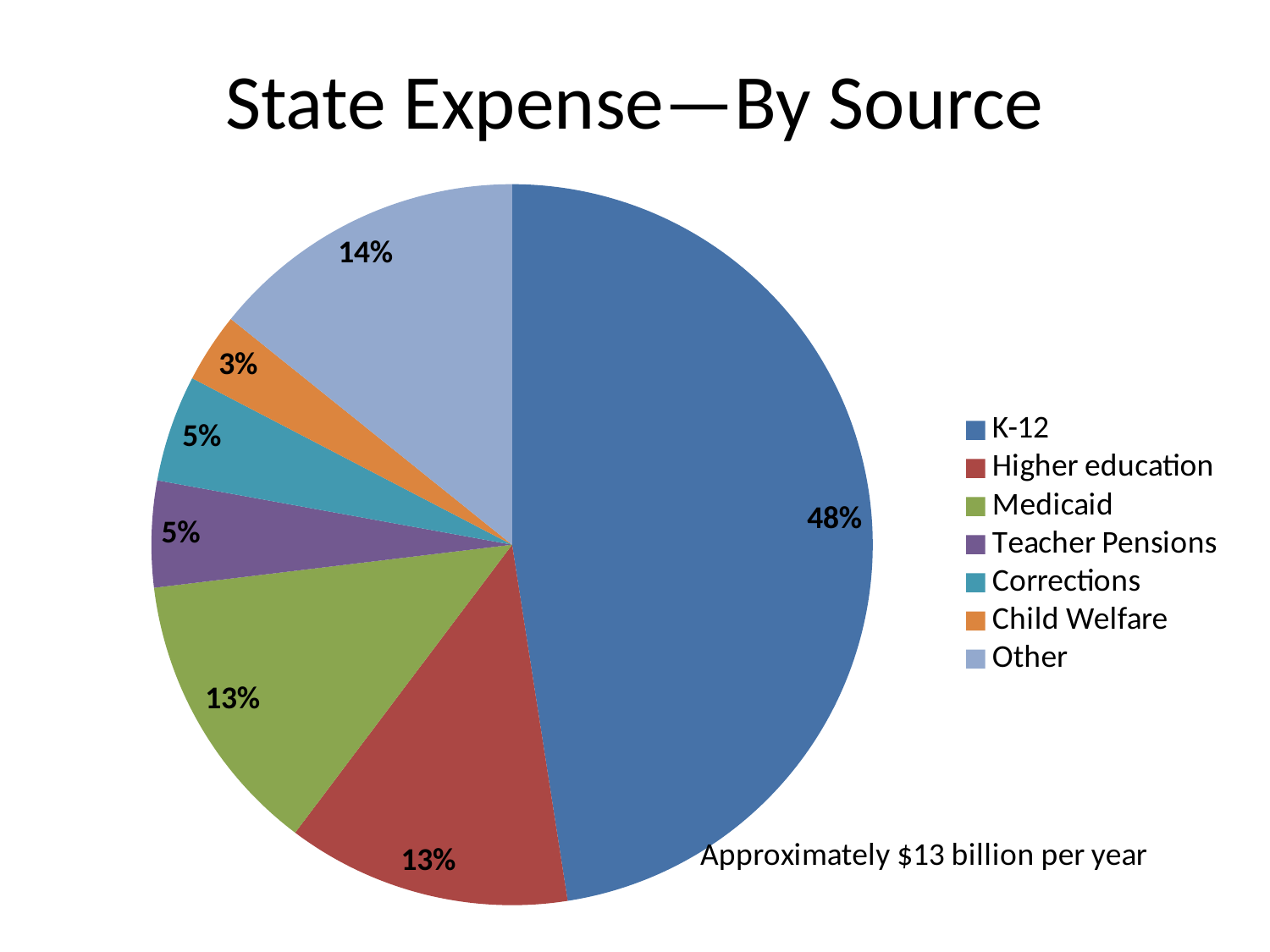
What share does Child Welfare represent? 3% How many categories does the legend list? 7 What percentage is labelled for the Other slice? 14% Which is larger, the share for Other or the share for Higher education? Other Which category has the largest share of state expense? K-12 What is the difference in percentage points between K-12 and Other? 34 What share of state expense goes to Corrections? 5% Which category has the smallest share of state expense? Child Welfare What is the title of the chart? State Expense—By Source What kind of chart is shown on the slide? Pie chart